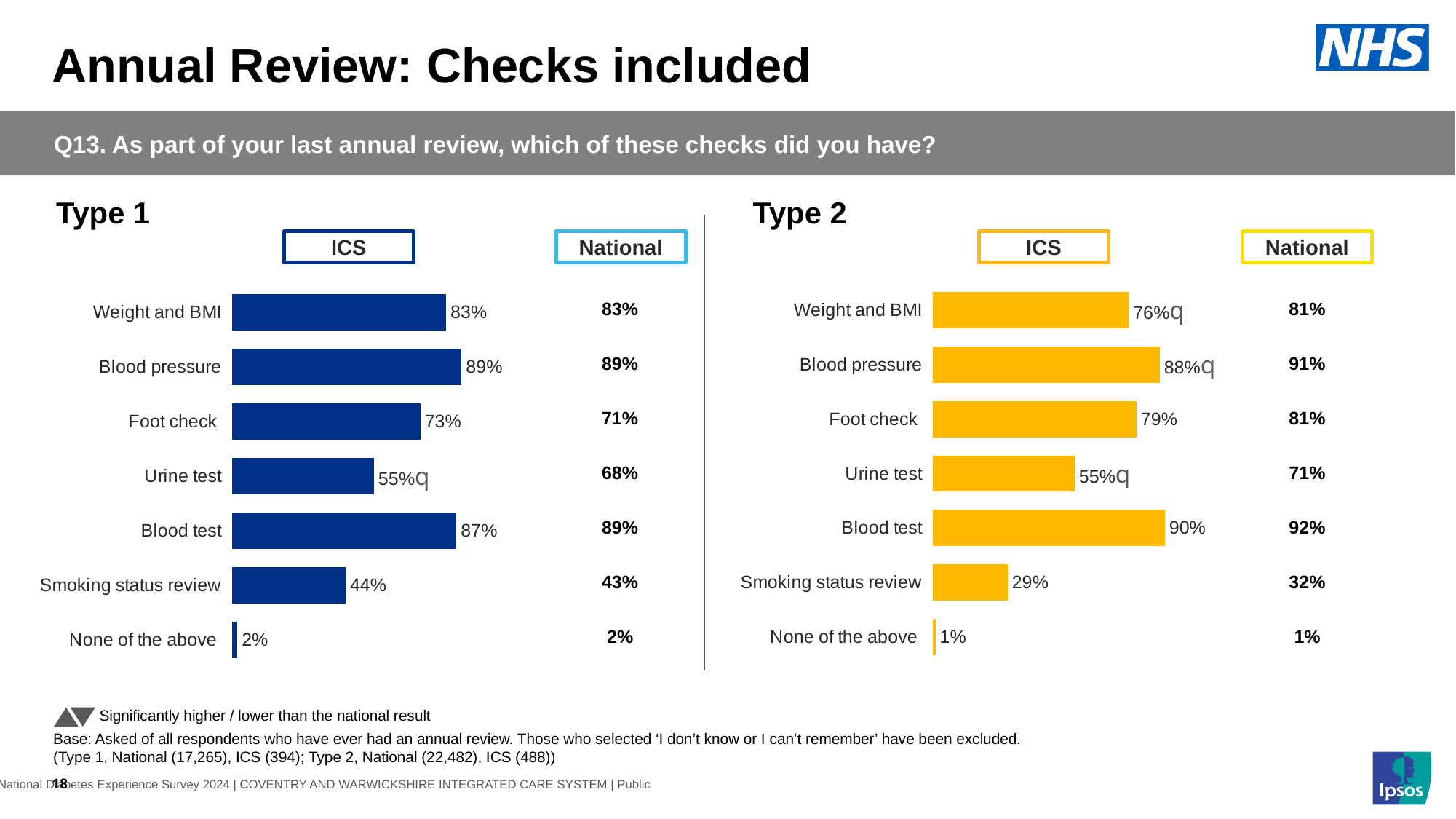
In the Type 2 chart, is the ICS value for Weight and BMI larger or smaller than the National value? smaller What type of chart is used for the Type 2 ICS results? Bar chart In the Type 1 chart, what is the ICS value for Foot check? 73% In the Type 2 chart, what is the ICS value for Blood test? 90% In the Type 2 chart, what is the difference between the National and ICS values for Urine test? 16 percentage points In the Type 2 chart, what is the National value for Smoking status review? 32% In the Type 1 chart, what is the National value for Urine test? 68% In the Type 2 chart, which category has the lowest ICS value? None of the above In the Type 1 chart, what is the difference between the ICS values for Blood pressure and Smoking status review? 45 percentage points In the Type 1 chart, which check has the highest ICS value? Blood pressure How many checks are listed in the Type 1 chart? 7 What colour are the bars in the Type 2 chart? Yellow